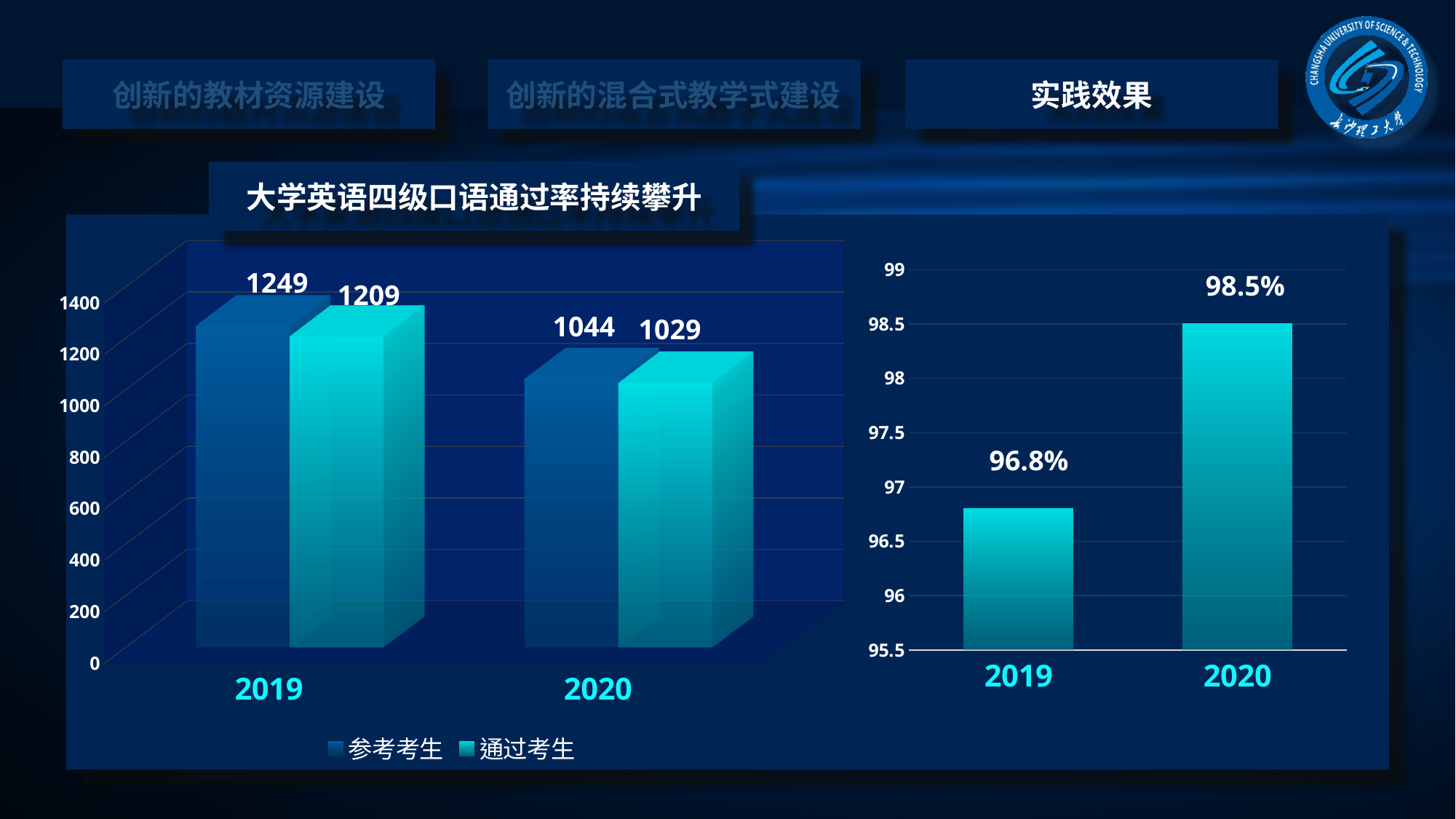
In the right chart, do the values rise or fall from 2019 to 2020? rise In the left chart, what is the value of 通过考生 for 2020? 1029 In the left chart, what is the difference between 参考考生 and 通过考生 in 2019? 40 In the left chart, which year has the higher value for 通过考生? 2019 In the right chart, what is the pass rate shown for 2019? 96.8% In the left chart, what is the difference between 参考考生 in 2019 and 参考考生 in 2020? 205 How many categories are shown on the x axis of the right chart? 2 What kind of chart is the right chart? bar chart How many series does the legend of the left chart list? 2 In the right chart, what is the pass rate shown for 2020? 98.5% In the left chart, what is the value of 参考考生 for 2019? 1249 In the right chart, which year has the lowest pass rate? 2019